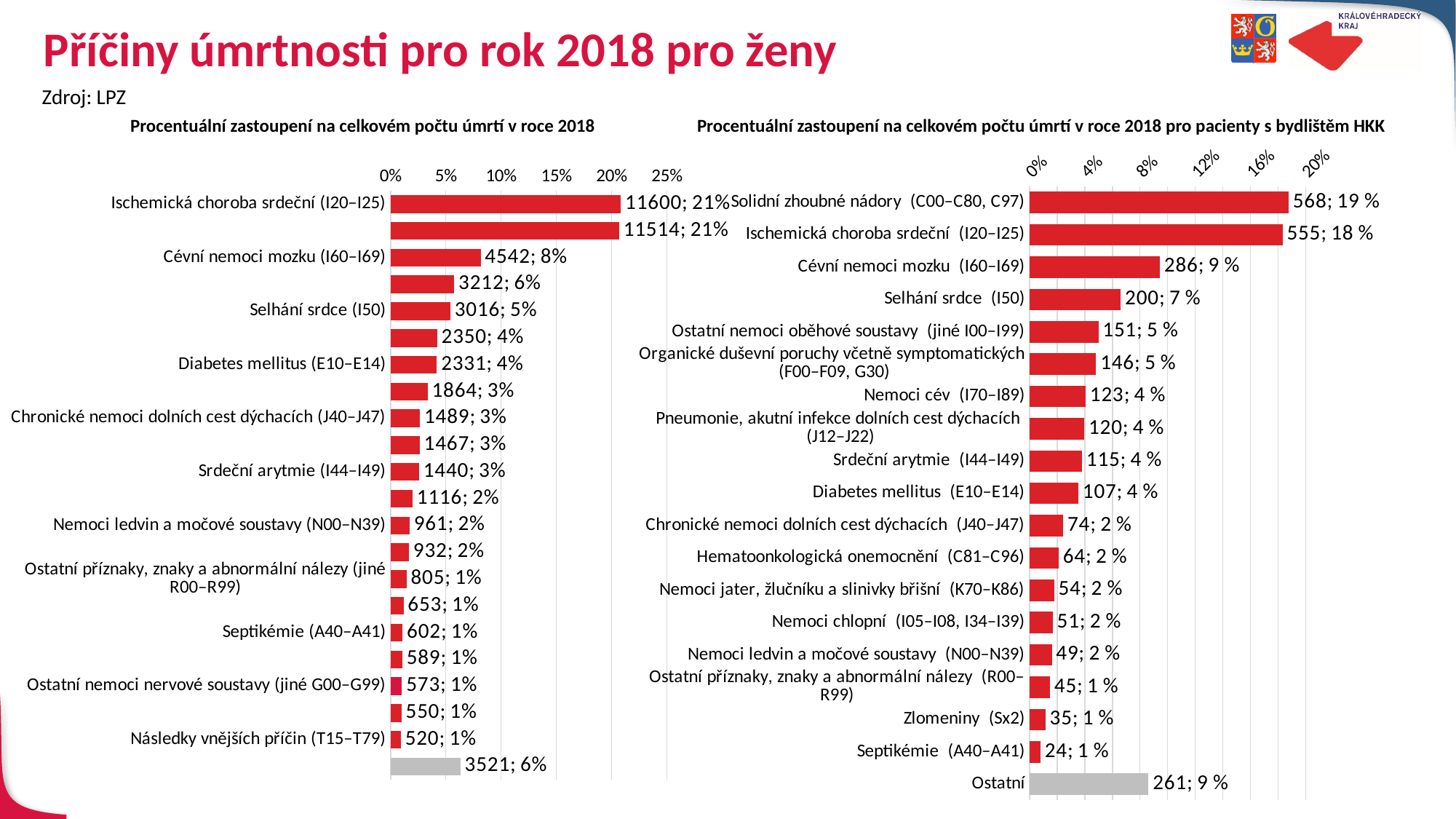
What type of chart is the left chart (Procentuální zastoupení na celkovém počtu úmrtí v roce 2018)? Bar chart In the left chart (Procentuální zastoupení na celkovém počtu úmrtí v roce 2018), what is the data label for Septikémie (A40–A41)? 602; 1% In the right chart (pro pacienty s bydlištěm HKK), which named cause has the lowest value? Septikémie (A40–A41) In the right chart (pro pacienty s bydlištěm HKK), what is the data label for Selhání srdce (I50)? 200; 7 % In the right chart (pro pacienty s bydlištěm HKK), which is larger: Nemoci cév (I70–I89) or Diabetes mellitus (E10–E14)? Nemoci cév (I70–I89) In the right chart (pro pacienty s bydlištěm HKK), how many bars are plotted? 19 In the left chart (Procentuální zastoupení na celkovém počtu úmrtí v roce 2018), what is the data label for Cévní nemoci mozku (I60–I69)? 4542; 8% In the right chart (pro pacienty s bydlištěm HKK), which named cause has the highest value? Solidní zhoubné nádory (C00–C80, C97) In the right chart (pro pacienty s bydlištěm HKK), what is the difference in count between Solidní zhoubné nádory and Ischemická choroba srdeční? 13 In the right chart (pro pacienty s bydlištěm HKK), which bar is coloured grey instead of red? Ostatní In the left chart (Procentuální zastoupení na celkovém počtu úmrtí v roce 2018), what is the difference in count between Selhání srdce (I50) and Diabetes mellitus (E10–E14)? 685 In the right chart (pro pacienty s bydlištěm HKK), what is the data label for Solidní zhoubné nádory (C00–C80, C97)? 568; 19 %